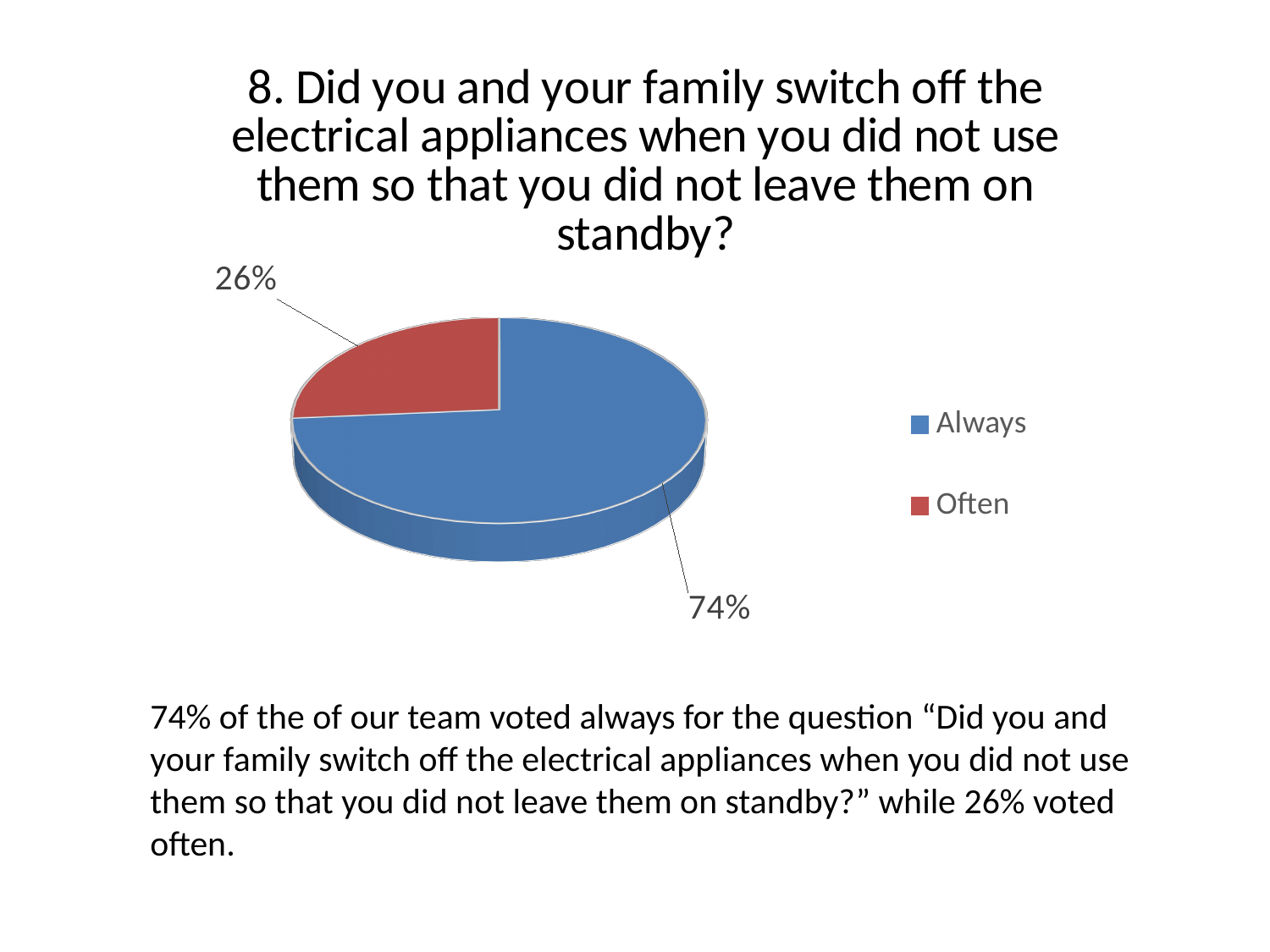
What is the difference in percentage points between the Always and Often slices? 48 What colour is the Often slice? Red What kind of chart is shown on the slide? Pie chart What share of the pie does the Always slice represent? 74% What share of the pie does the Often slice represent? 26% How many entries does the legend list? 2 Which category has the largest slice of the pie? Always Which slice is larger, Always or Often? Always Which category has the smallest slice of the pie? Often What colour is the Always slice? Blue How many slices does the pie chart have? 2